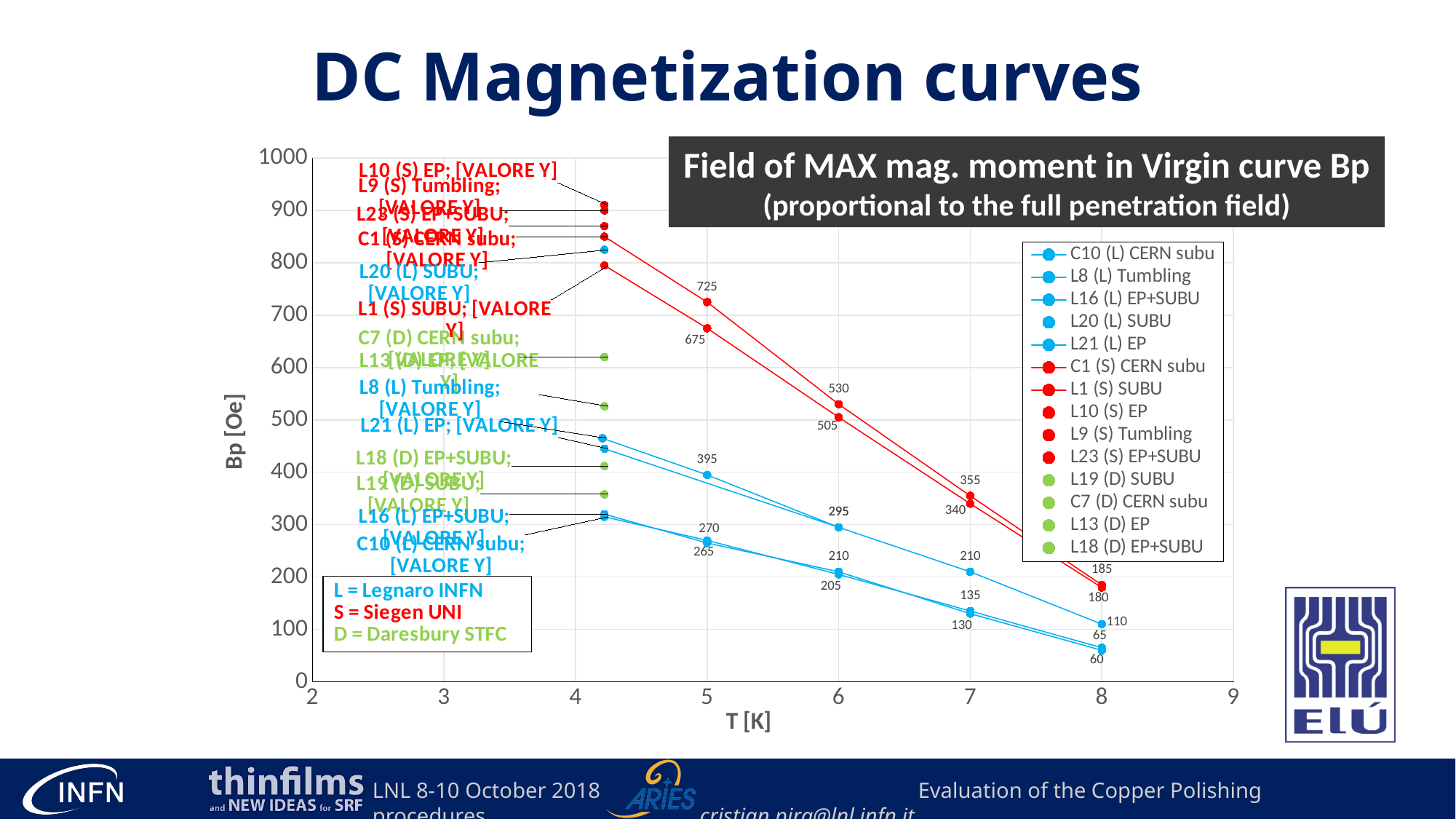
According to the key box, which institution does the letter S stand for? Siegen UNI At T = 6 K, which labelled blue-series value is larger, 295 or 210? 295 What is the highest data-labelled value at T = 5 K? 725 What is the label of the y axis? Bp [Oe] Do the Bp values of the plotted curves rise or fall as T increases from 4.2 K to 8 K? fall Is the value for L20 (L) SUBU at 4.2 K greater or less than 800? greater Is the value for L18 (D) EP+SUBU at 4.2 K greater or less than 500? less What kind of chart is shown on the slide? line chart How many series does the legend list? 14 What is the lowest data-labelled value at T = 8 K? 60 What is the difference between the two red-series values labelled at T = 8 K (185 and 180)? 5 What is the difference between the two red-series values labelled at T = 5 K (725 and 675)? 50